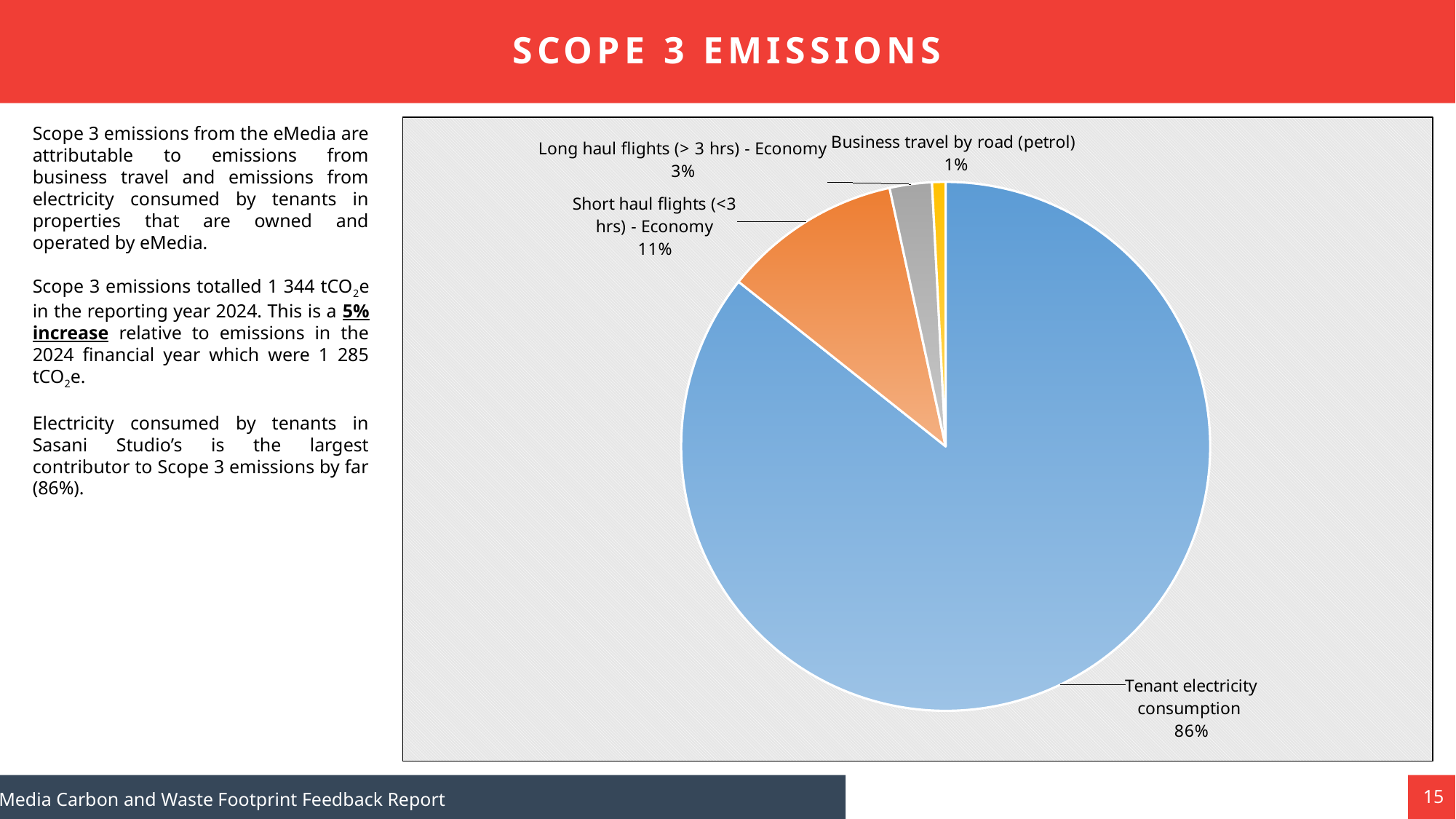
What share of Scope 3 emissions comes from Short haul flights (<3 hrs) - Economy? 11% Which is larger: the share for Short haul flights (<3 hrs) - Economy or Long haul flights (> 3 hrs) - Economy? Short haul flights (<3 hrs) - Economy What share of Scope 3 emissions comes from Business travel by road (petrol)? 1% What is the difference in percentage points between Short haul flights (<3 hrs) - Economy and Long haul flights (> 3 hrs) - Economy? 8% What colour is the Tenant electricity consumption slice? Blue What is the difference in percentage points between Tenant electricity consumption and Short haul flights (<3 hrs) - Economy? 75% Which category has the smallest slice of the pie? Business travel by road (petrol) How many categories are shown in the pie chart? 4 Which category has the largest slice of the pie? Tenant electricity consumption What kind of chart is shown on the slide? Pie chart What share of Scope 3 emissions comes from Tenant electricity consumption? 86%